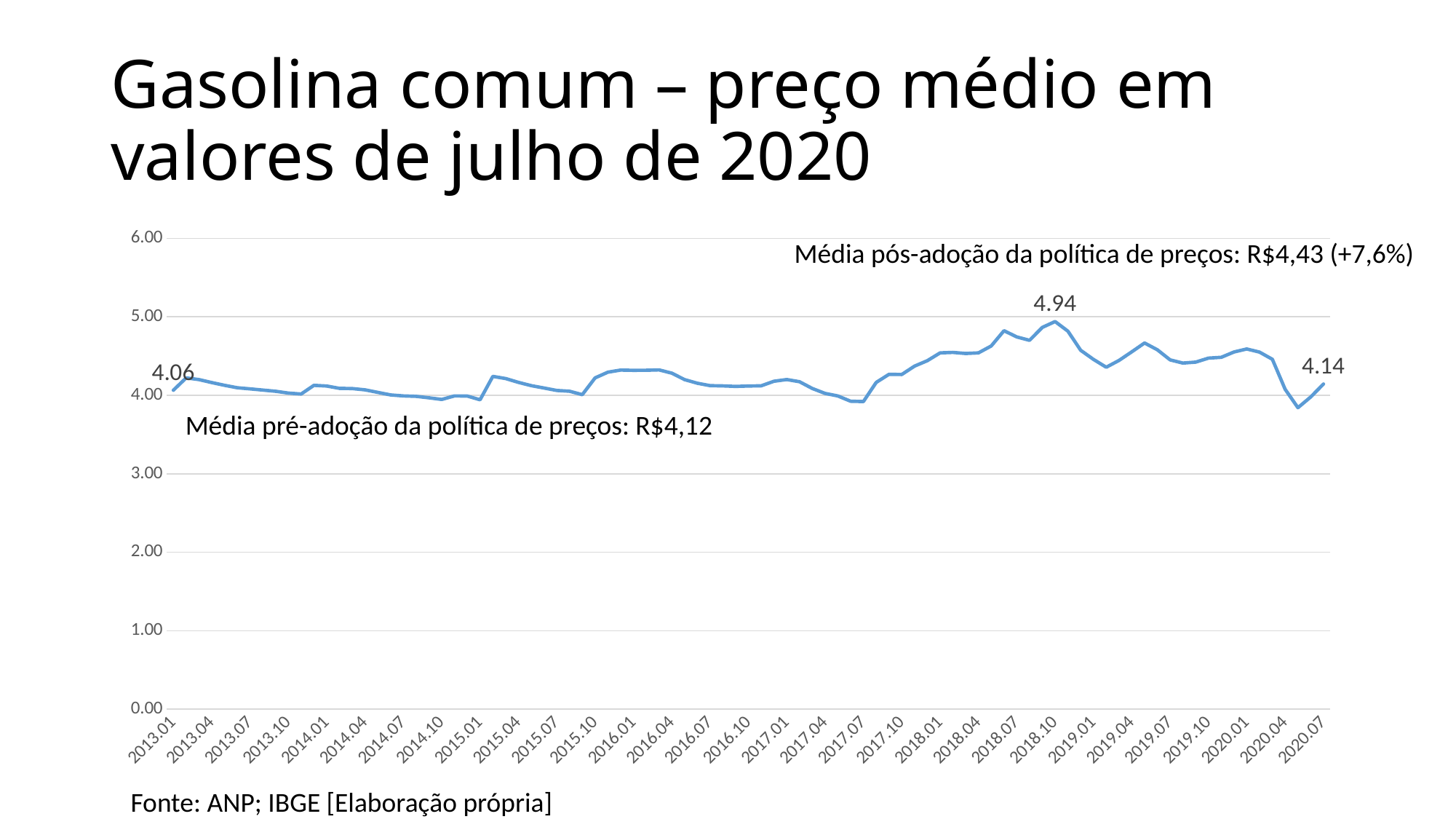
According to the annotation, what is the average price after the adoption of the pricing policy? R$4,43 What kind of chart is shown on the slide? line chart What is the difference between the value for 2020.07 and the value for 2013.01? 0.08 Which is larger, the value for 2013.01 or the value for 2020.07? 2020.07 What is the highest value labelled on the line? 4.94 What is the value shown for 2013.01? 4.06 What is the difference between the peak value (4.94) and the value for 2013.01 (4.06)? 0.88 Does the line rise or fall between 2017.07 and 2018.10? rise Around which month does the line reach its peak of 4.94? 2018.10 Is the value for 2018.07 greater or less than 5.00? less What is the value shown for 2020.07? 4.14